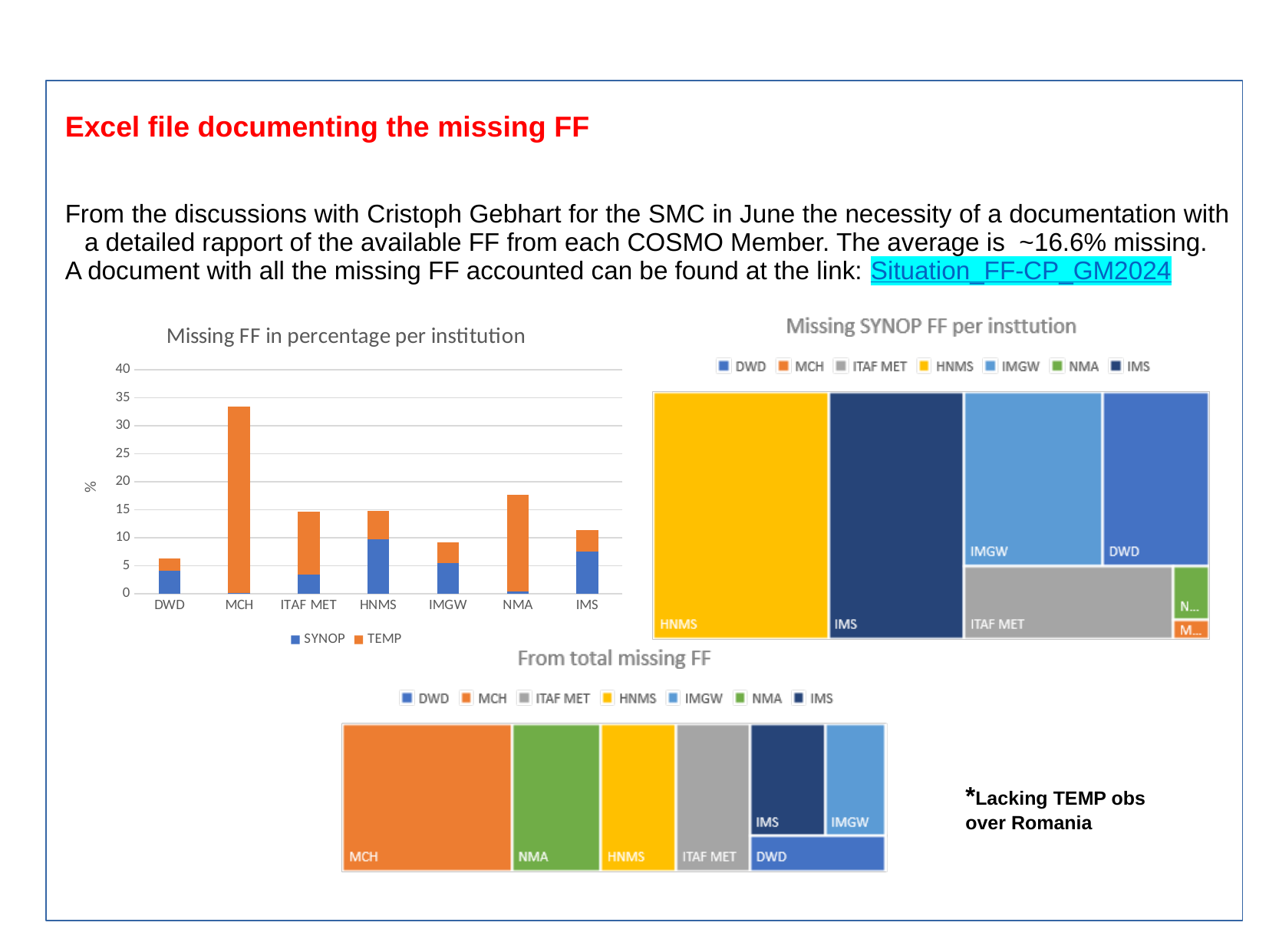
What kind of chart is the one titled 'Missing FF in percentage per institution'? Stacked bar chart In the chart titled 'Missing FF in percentage per institution', which has a larger total missing percentage, NMA or IMGW? NMA In the chart titled 'Missing FF in percentage per institution', is the total value for DWD greater or less than 10? less In the chart titled 'From total missing FF', which institution occupies the largest area? MCH In the chart titled 'Missing FF in percentage per institution', which institution has the lowest total missing percentage? DWD In the chart titled 'Missing FF in percentage per institution', which institution has the highest total missing percentage? MCH How many series does the legend of the chart titled 'Missing FF in percentage per institution' list? 2 In the chart titled 'Missing FF in percentage per institution', is the total value for MCH greater or less than 30? greater In the chart titled 'Missing FF in percentage per institution', is the total value for IMS greater or less than 15? less How many institutions are shown on the x axis of the chart titled 'Missing FF in percentage per institution'? 7 In the chart titled 'Missing SYNOP FF per insttution', which institution occupies the largest area? HNMS